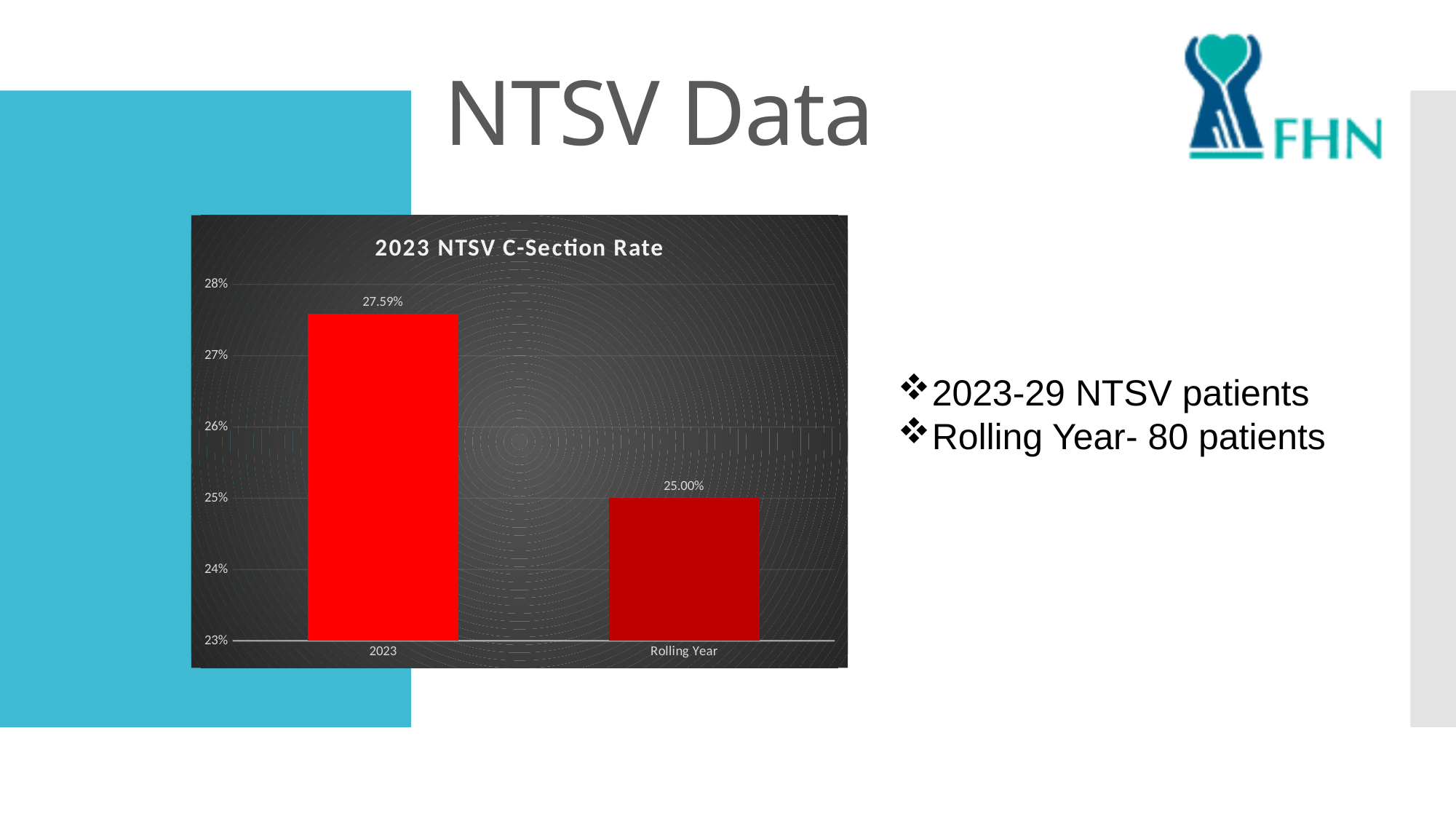
Which category has the lower C-section rate? Rolling Year What is the NTSV C-section rate for 2023? 27.59% Is the value for Rolling Year greater or less than 26%? less What is the title of the chart? 2023 NTSV C-Section Rate What is the difference between the 2023 rate and the Rolling Year rate? 2.59% What is the NTSV C-section rate for the Rolling Year? 25.00% How many categories are shown on the x axis? 2 Which category has the higher C-section rate? 2023 Is the value for 2023 greater or less than 27%? greater What kind of chart is shown on the slide? bar chart Do the values rise or fall from 2023 to Rolling Year? fall Is the 2023 rate larger or smaller than the Rolling Year rate? larger